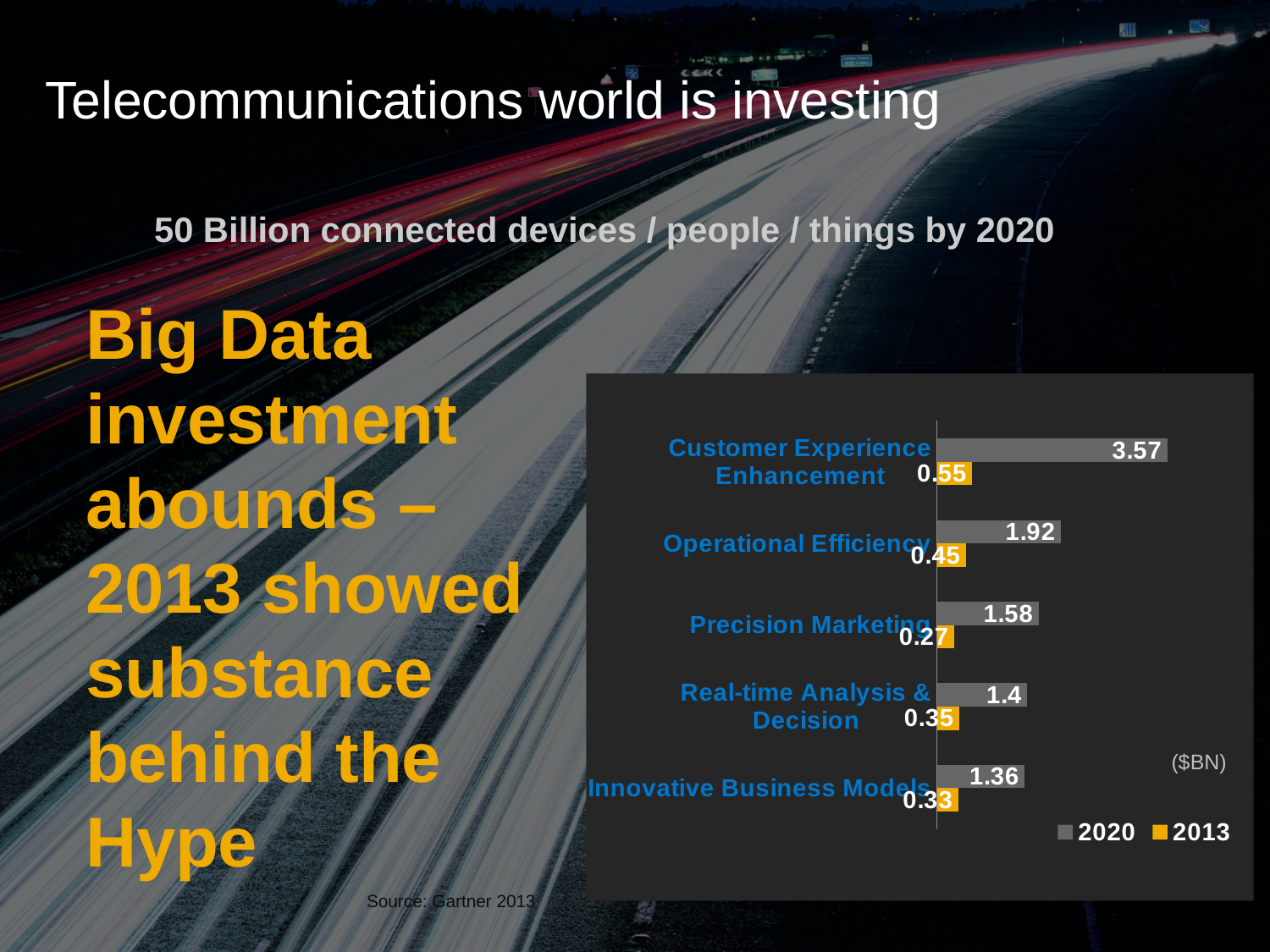
Which category has the highest 2020 value? Customer Experience Enhancement What unit is indicated for the values in the chart? $BN What is the difference between the 2020 and 2013 values for Customer Experience Enhancement? 3.02 What is the 2020 value for Customer Experience Enhancement? 3.57 Which category has the lowest 2013 value? Precision Marketing How many series does the chart legend list? 2 Which is larger: the 2020 value for Operational Efficiency or the 2020 value for Real-time Analysis & Decision? Operational Efficiency What is the 2020 value for Innovative Business Models? 1.36 What is the 2013 value for Precision Marketing? 0.27 How many categories are shown in the chart? 5 What is the 2013 value for Operational Efficiency? 0.45 What kind of chart is shown on the slide? bar chart